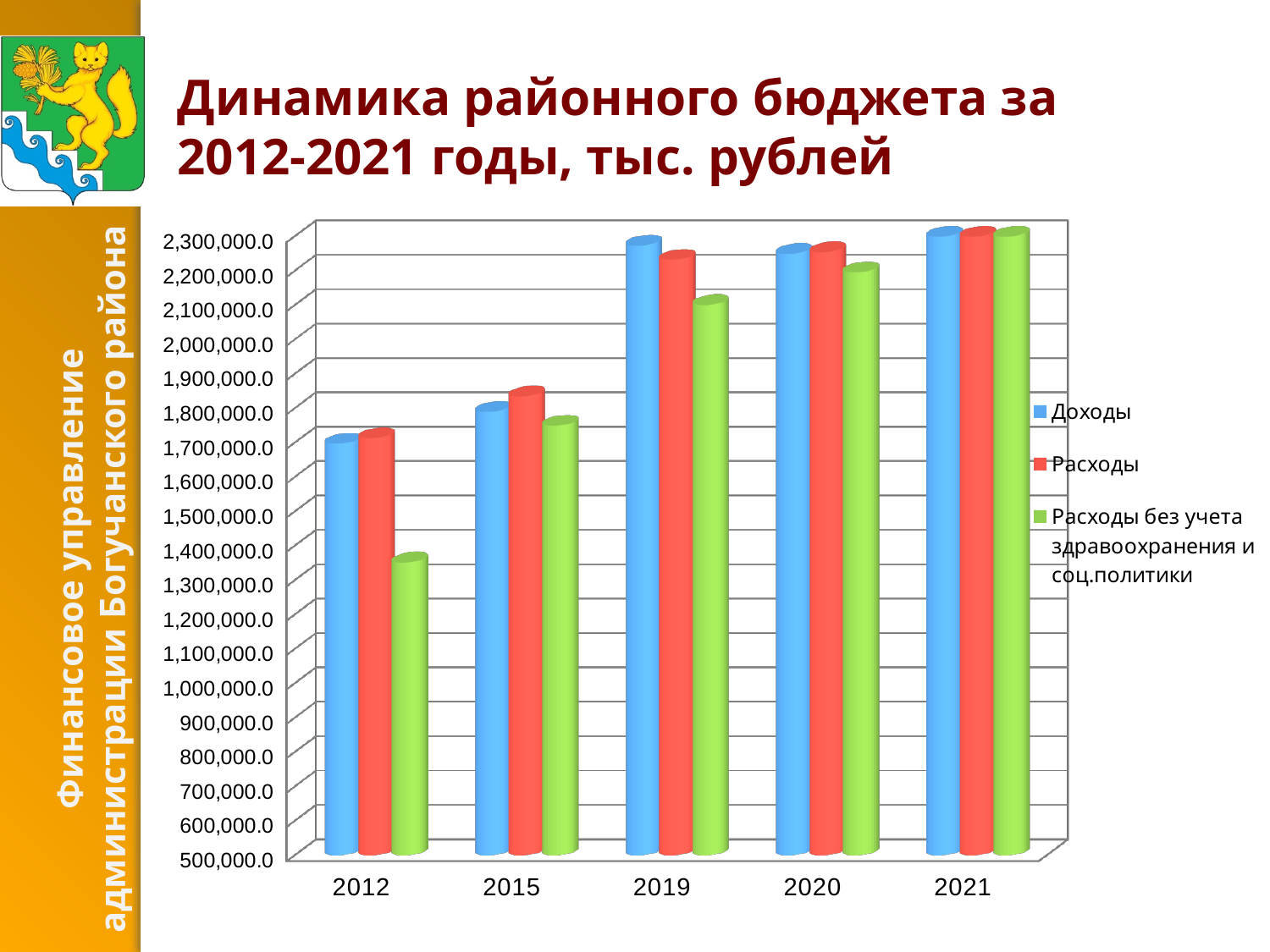
Which series is shown in green in the chart? Расходы без учета здравоохранения и соц.политики In which year is the value for Расходы без учета здравоохранения и соц.политики the lowest? 2012 What kind of chart is shown on the slide? bar chart Is the value for Доходы in 2019 greater or less than 2,200,000.0? greater Is the value for Доходы in 2012 greater or less than 1,800,000.0? less Do the values for Расходы без учета здравоохранения и соц.политики rise or fall from 2012 to 2021? rise In which year is the value for Расходы без учета здравоохранения и соц.политики the highest? 2021 How many series does the chart legend list? 3 In 2012, which is larger: Доходы or Расходы без учета здравоохранения и соц.политики? Доходы Is the value for Расходы без учета здравоохранения и соц.политики in 2012 greater or less than 1,500,000.0? less How many years are shown on the x axis of the chart? 5